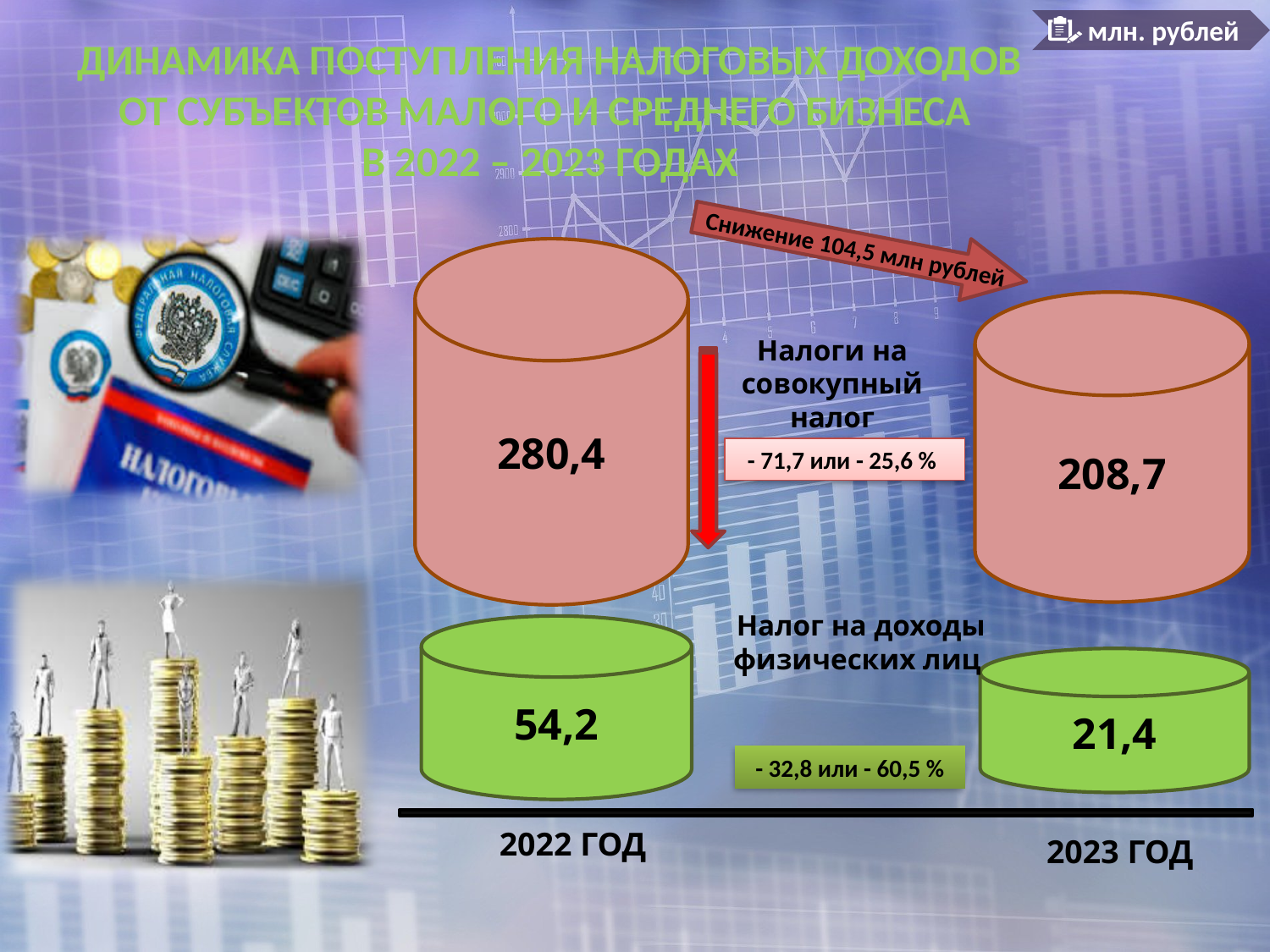
What was the value of taxes on the aggregate tax (Налоги на совокупный налог) in 2023? 208,7 What was the value of personal income tax (Налог на доходы физических лиц) in 2023? 21,4 By how much did personal income tax decrease from 2022 to 2023, according to the slide? - 32,8 или - 60,5 % What was the value of taxes on the aggregate tax (Налоги на совокупный налог) in 2022? 280,4 What is the total decrease in tax revenue shown in the arrow at the top of the slide? Снижение 104,5 млн рублей Which year had the lower value of personal income tax, 2022 or 2023? 2023 What was the value of personal income tax (Налог на доходы физических лиц) in 2022? 54,2 Did the tax revenues shown on the slide rise or fall from 2022 to 2023? fall In what units are the values on the slide expressed? млн. рублей By how much did taxes on the aggregate tax decrease from 2022 to 2023, according to the slide? - 71,7 или - 25,6 % What colour are the cylinders representing personal income tax (Налог на доходы физических лиц)? green Which year had the higher value of taxes on the aggregate tax, 2022 or 2023? 2022